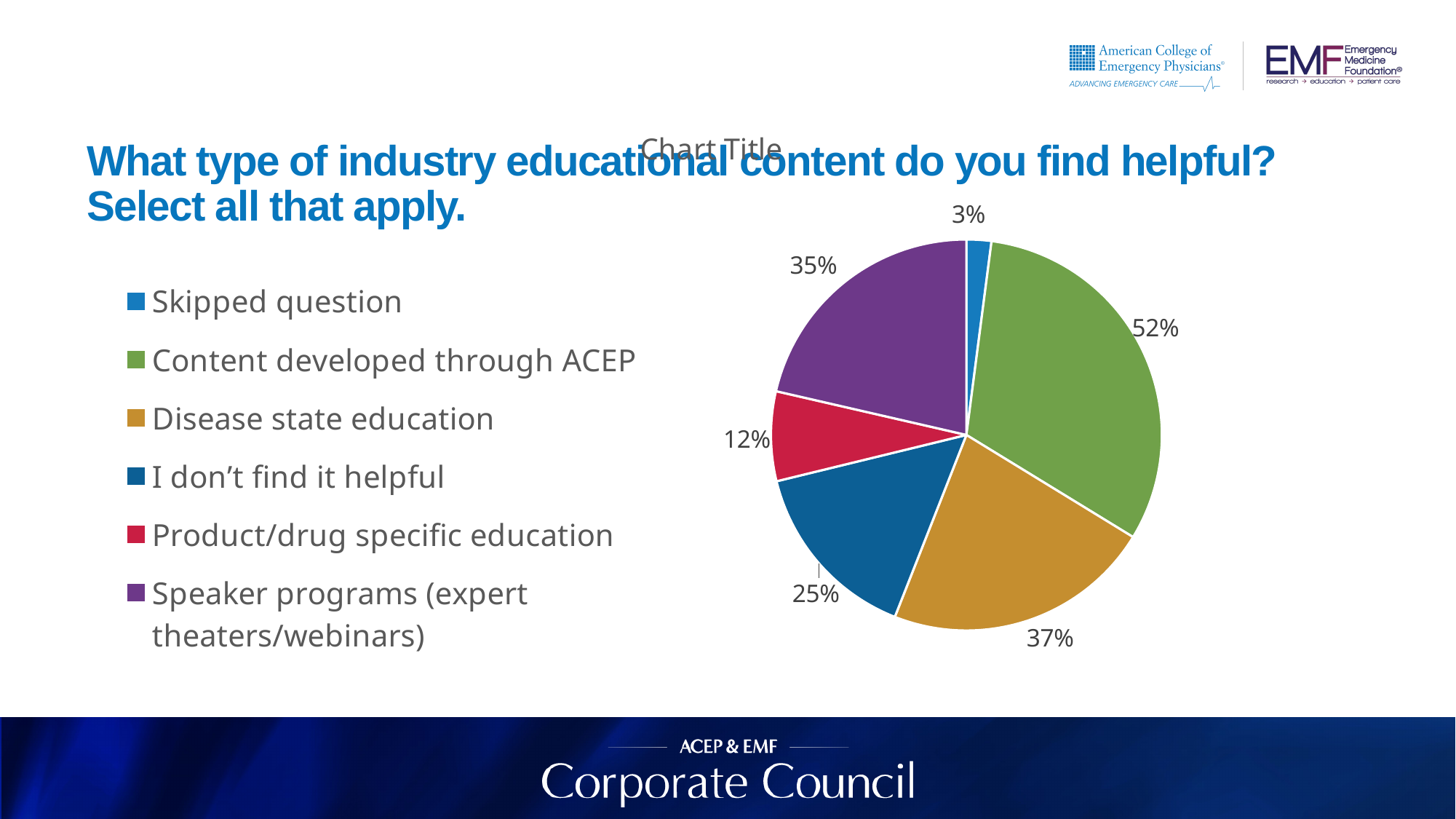
What is the value shown for I don't find it helpful? 25% What is the value shown for Skipped question? 3% What is the value shown for Product/drug specific education? 12% Which category has the lowest value in the pie chart? Skipped question How many categories does the legend of the pie chart list? 6 What is the difference between the values for Content developed through ACEP and Disease state education? 15% Which category has the highest value in the pie chart? Content developed through ACEP Which is larger, the value for Speaker programs (expert theaters/webinars) or the value for I don't find it helpful? Speaker programs (expert theaters/webinars) What is the value shown for Disease state education? 37% What is the value shown for Content developed through ACEP? 52% What is the value shown for Speaker programs (expert theaters/webinars)? 35% What type of chart is shown on the slide? pie chart